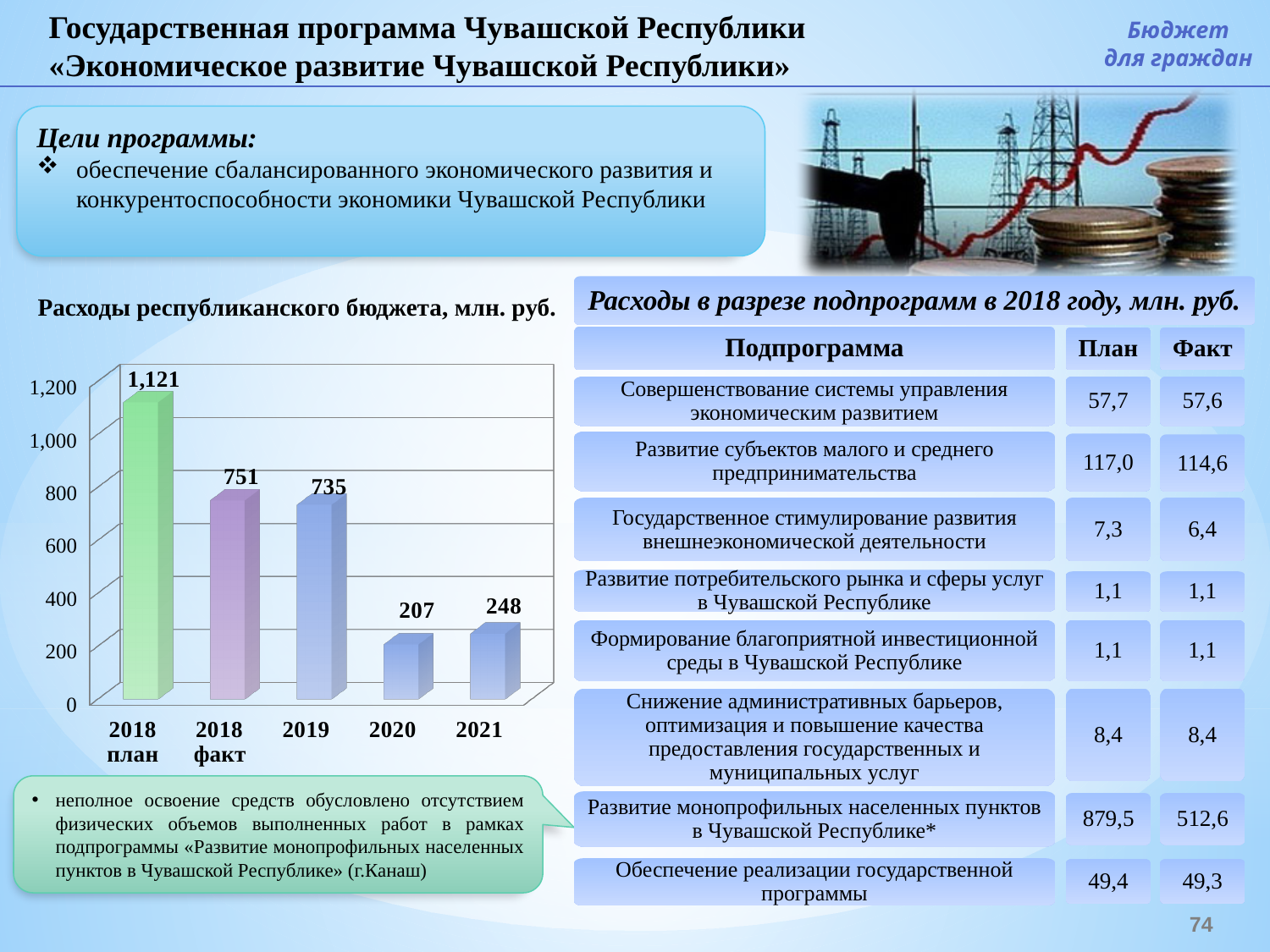
What is the value for 2021 in the chart 'Расходы республиканского бюджета, млн. руб.'? 248 What is the difference between the 2021 and 2020 values in the chart 'Расходы республиканского бюджета, млн. руб.'? 41 In the chart 'Расходы республиканского бюджета, млн. руб.', which is larger: the value for 2020 or the value for 2021? 2021 What is the title of the chart on the left side of the slide? Расходы республиканского бюджета, млн. руб. What is the value for 2019 in the chart 'Расходы республиканского бюджета, млн. руб.'? 735 Which category has the lowest value in the chart 'Расходы республиканского бюджета, млн. руб.'? 2020 What is the value for 2018 план in the chart 'Расходы республиканского бюджета, млн. руб.'? 1,121 How many bars are shown in the chart 'Расходы республиканского бюджета, млн. руб.'? 5 What is the value for 2018 факт in the chart 'Расходы республиканского бюджета, млн. руб.'? 751 What type of chart is 'Расходы республиканского бюджета, млн. руб.'? Bar chart What is the difference between the 2018 план and 2018 факт values in the chart 'Расходы республиканского бюджета, млн. руб.'? 370 Which category has the highest value in the chart 'Расходы республиканского бюджета, млн. руб.'? 2018 план